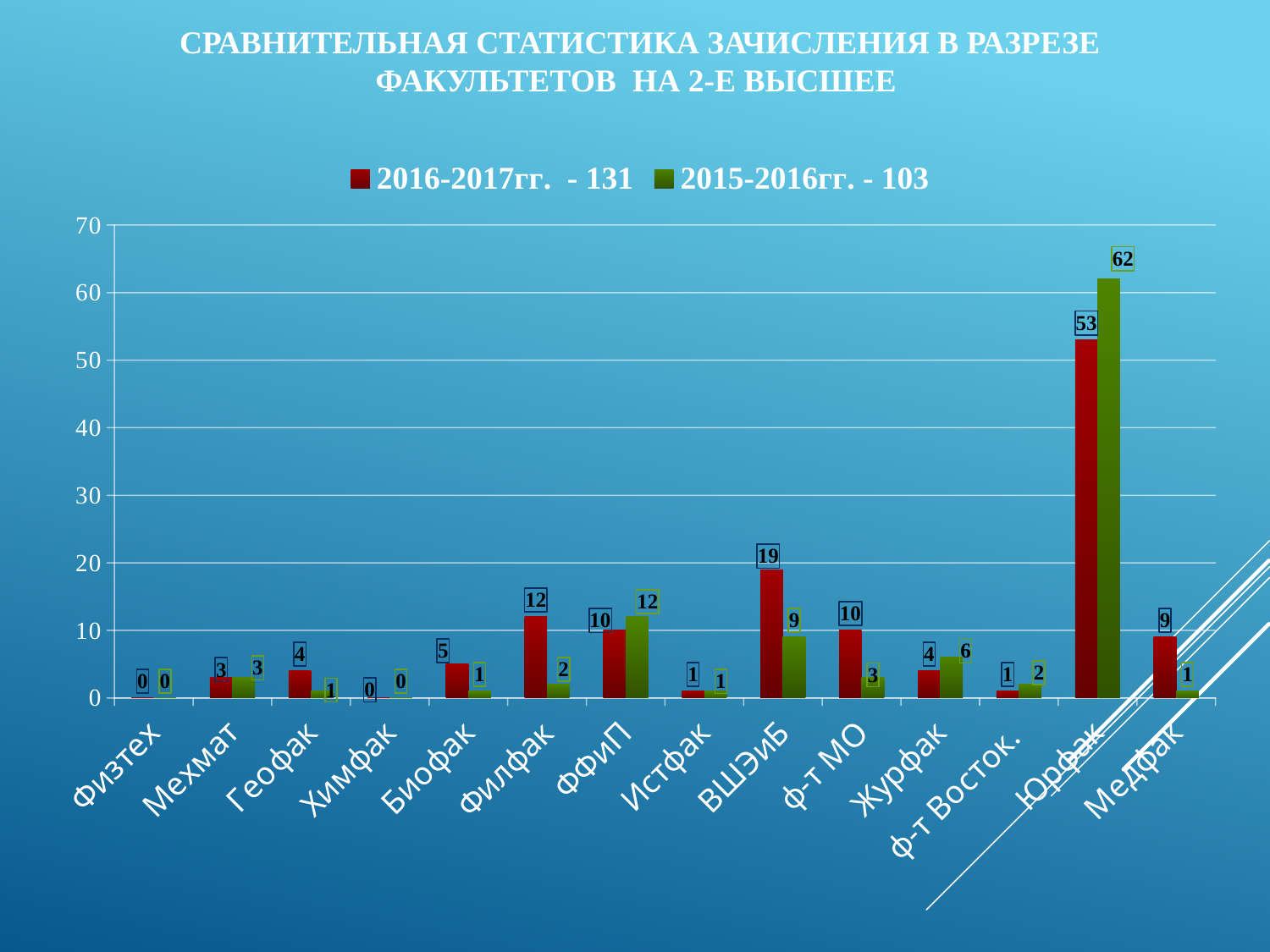
What is the value for ВШЭиБ in the 2015-2016гг. series? 9 What is the value for Филфак in the 2016-2017гг. series? 12 Which faculty has the highest value in the 2015-2016гг. series? Юрфак What is the difference between the 2016-2017гг. and 2015-2016гг. values for ВШЭиБ? 10 What is the value for Медфак in the 2015-2016гг. series? 1 How many faculties (categories) are shown on the x axis? 14 What is the value for Юрфак in the 2016-2017гг. series? 53 What is the difference between the 2015-2016гг. and 2016-2017гг. values for Юрфак? 9 Which is larger for ФФиП: the 2016-2017гг. value or the 2015-2016гг. value? 2015-2016гг. What type of chart is shown on the slide? bar chart How many series does the legend list? 2 What total is shown in the legend entry for the 2016-2017гг. series? 131